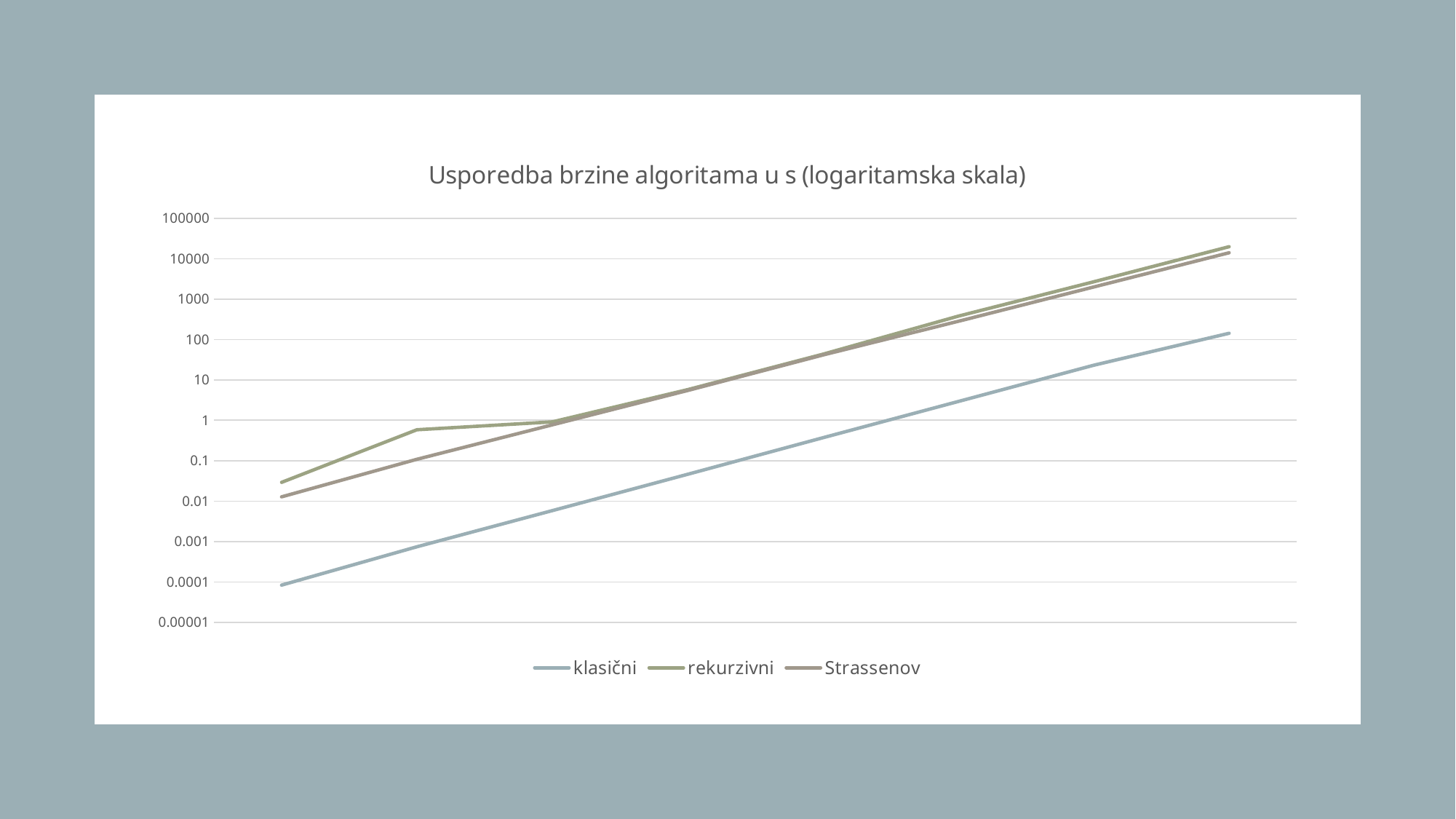
What is the title of the chart? Usporedba brzine algoritama u s (logaritamska skala) Which series are listed in the legend? klasični, rekurzivni, Strassenov Which series has the lowest value at the rightmost point of the chart? klasični Is the value for klasični at the rightmost point greater or less than 100? greater Which series has the highest value at the rightmost point of the chart? rekurzivni What kind of chart is shown on the slide? line chart Do the values of the klasični series rise or fall along the x axis? rise How many series does the legend list? 3 Is the value for klasični at the leftmost point greater or less than 0.001? less Is the value for rekurzivni at the rightmost point greater or less than 10000? greater At the rightmost point, is the value for rekurzivni larger or smaller than the value for klasični? larger